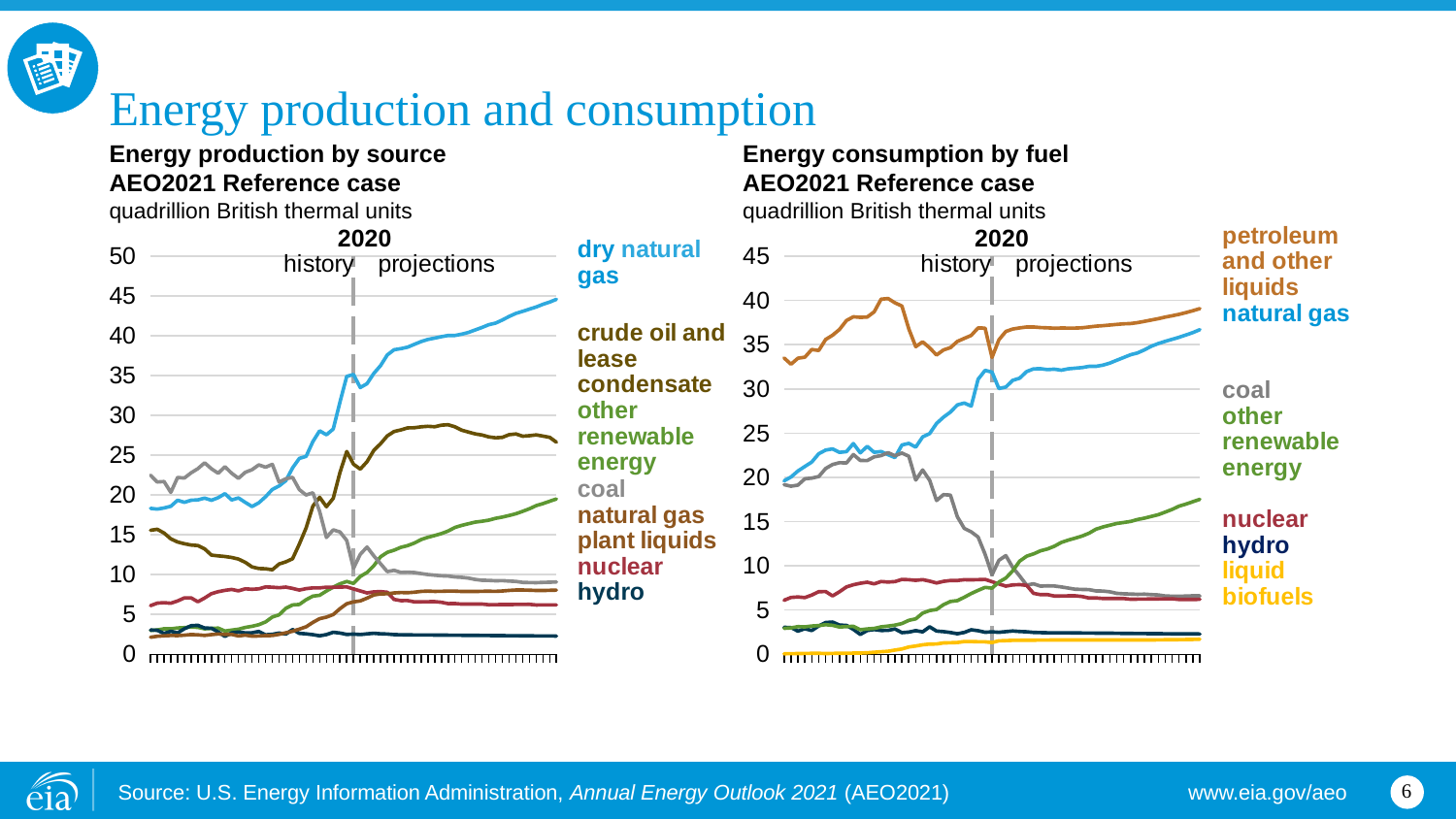
In the 'Energy consumption by fuel' chart, is the value for coal at the end of the projections greater or less than 10? less How many series are labelled on the 'Energy production by source' chart on the left? 7 In the 'Energy consumption by fuel' chart, is the value for petroleum and other liquids at the end of the projections greater or less than 35? greater How many series are labelled on the 'Energy consumption by fuel' chart on the right? 7 What kind of chart is the 'Energy production by source' chart on the left? line chart In the 'Energy consumption by fuel' chart, which fuel has the lowest value at the end of the projection period? liquid biofuels What year does the dashed vertical line separating history from projections mark on both charts? 2020 In the 'Energy production by source' chart, does the coal line rise or fall over the projection period? fall In the 'Energy consumption by fuel' chart, does the other renewable energy line rise or fall over the projection period? rise In the 'Energy consumption by fuel' chart, which is larger at the end of the projections: petroleum and other liquids or natural gas? petroleum and other liquids In the 'Energy production by source' chart, which source has the highest value at the end of the projection period? dry natural gas In the 'Energy production by source' chart, is the value for dry natural gas at the end of the projections greater or less than 40? greater